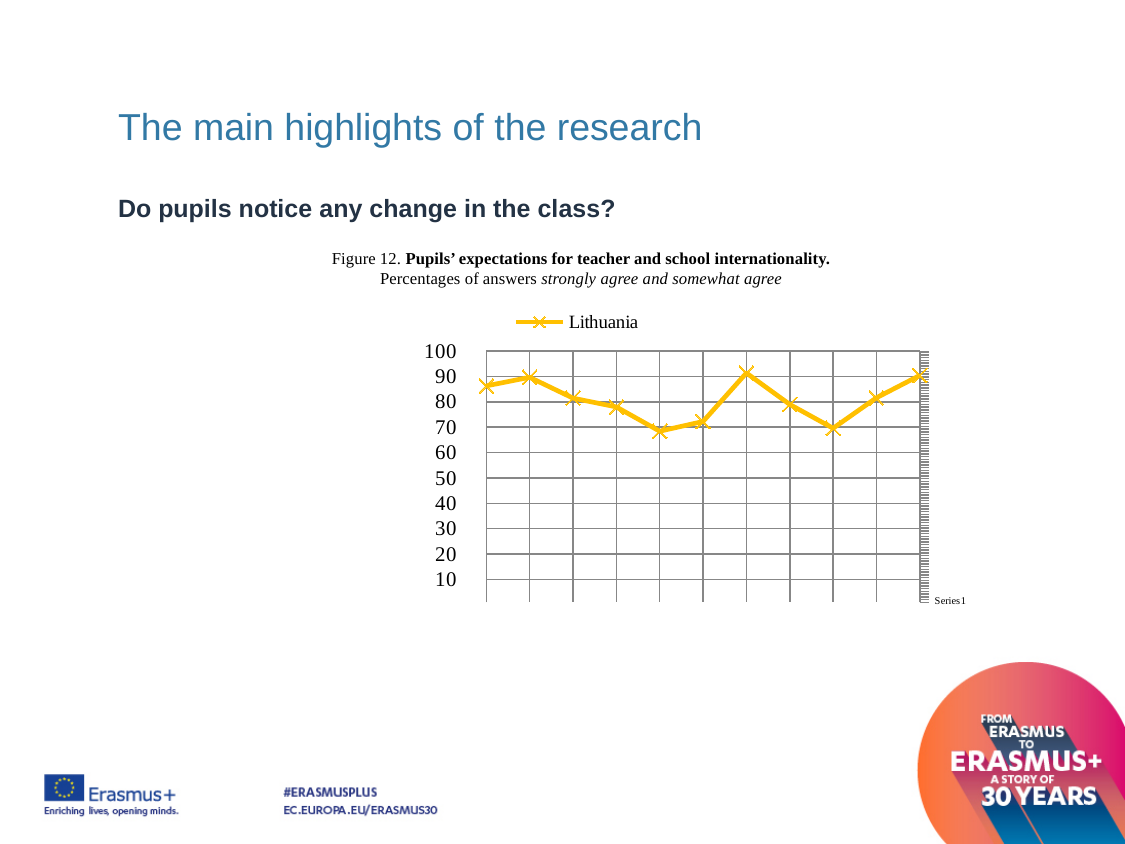
Are all the plotted values on the Lithuania line greater or less than 60? greater What is the figure number given in the chart caption? Figure 12 What kind of chart is shown on the slide? line chart What is the name of the series shown in the chart legend? Lithuania What is the highest value shown on the vertical axis? 100 How many data points are plotted on the Lithuania line? 11 Is the value of the rightmost point on the Lithuania line greater or less than 80? greater Is the value of the leftmost point on the Lithuania line greater or less than 80? greater